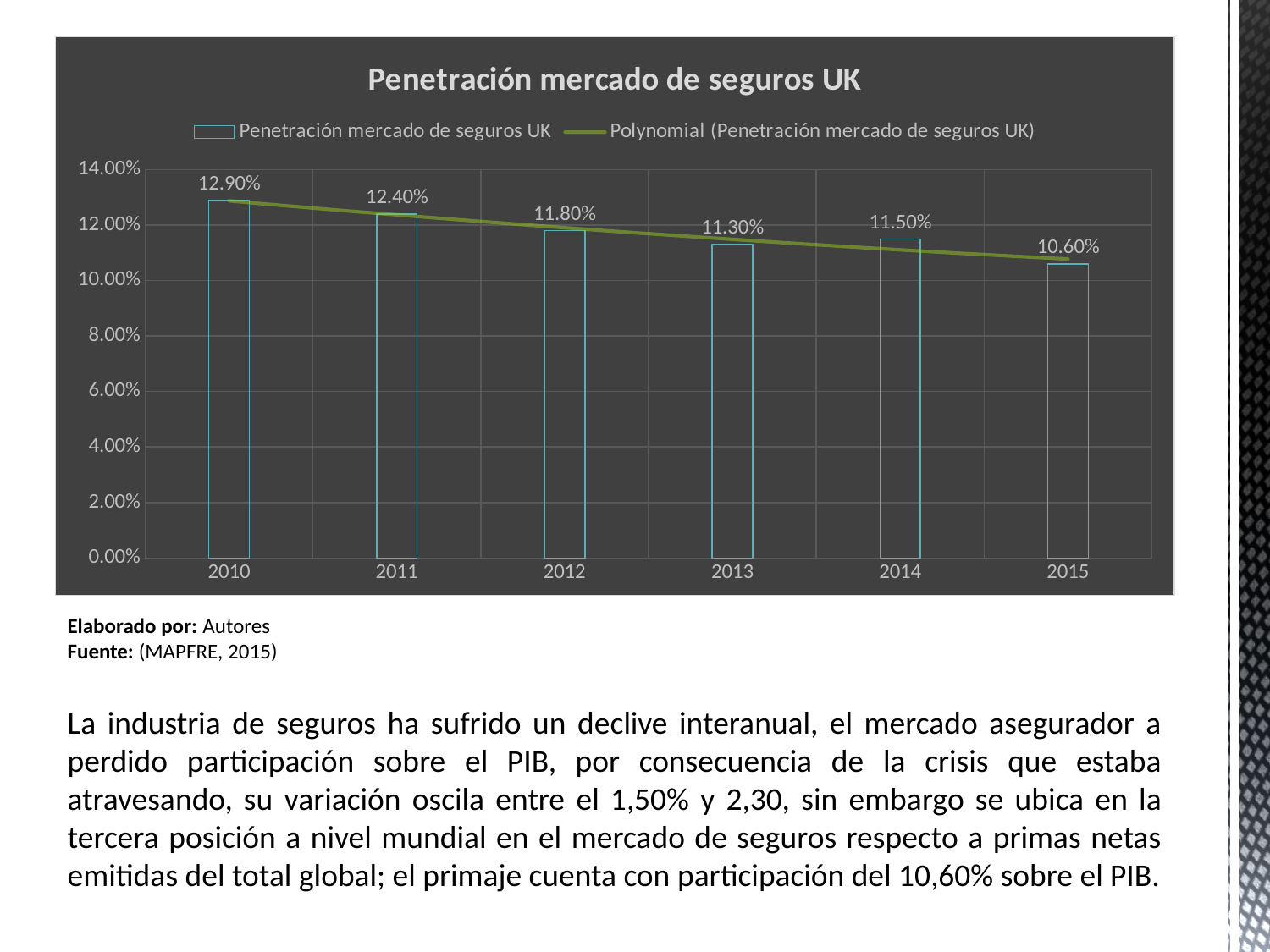
Do the values generally rise or fall from 2010 to 2015? fall Which year has the highest value? 2010 Which year has the lowest value? 2015 What is the difference between the values for 2010 and 2015? 2.30% What is the difference between the values for 2013 and 2014? 0.20% What is the value for 2013? 11.30% How many years are shown on the x axis? 6 Is the value for 2014 greater or less than 12.00%? less Which is larger, the value for 2011 or the value for 2012? 2011 What is the value for 2015? 10.60% What is the value for 2010? 12.90% What kind of chart is this? bar chart